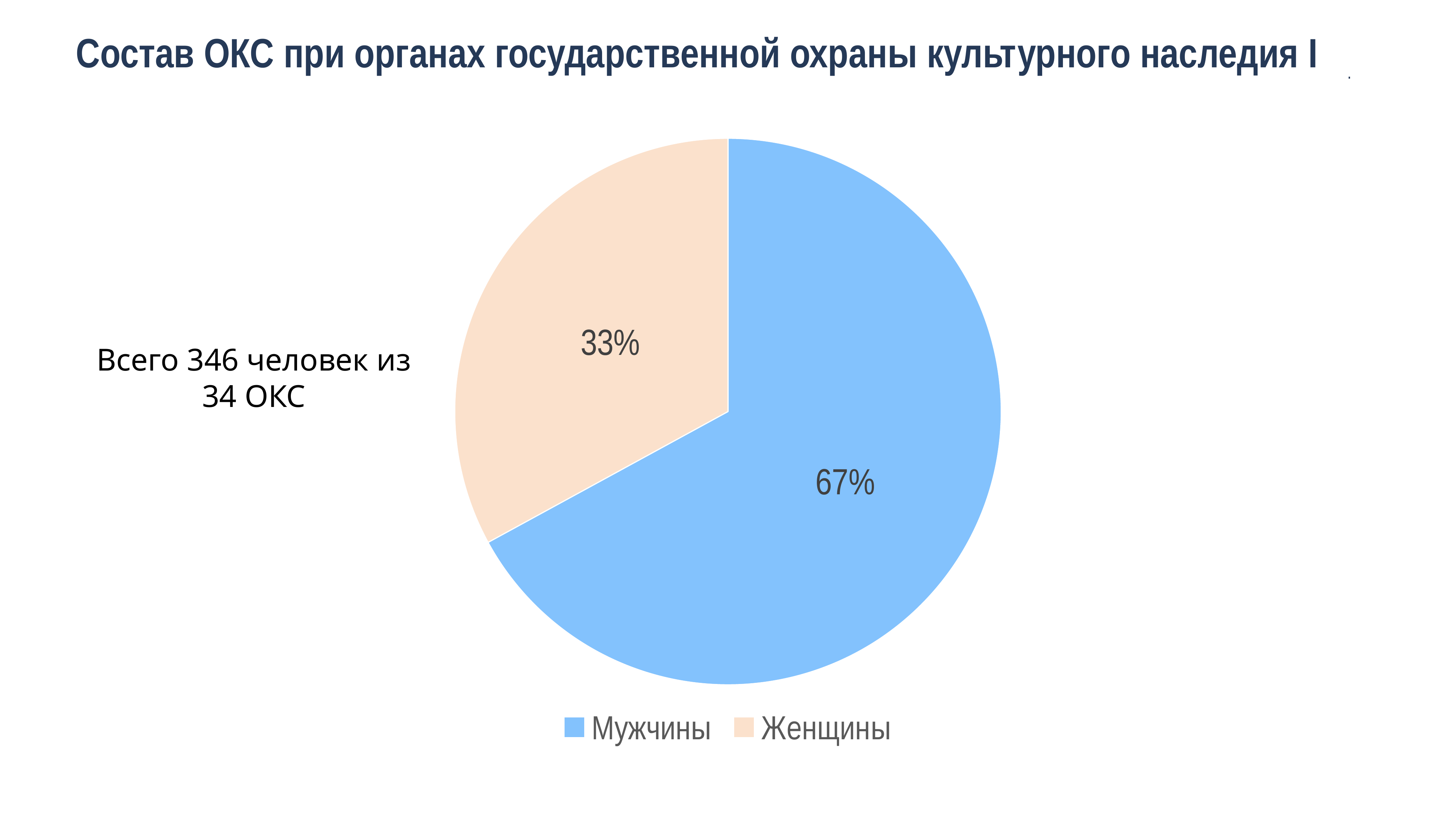
What kind of chart is shown on the slide? pie chart Which category has the largest slice of the pie? Мужчины What is the difference in percentage points between the Мужчины and Женщины slices? 34 What is the title of the slide? Состав ОКС при органах государственной охраны культурного наследия What share of the pie does Женщины represent? 33% How many slices does the pie chart have? 2 Which is larger, the slice for Мужчины or the slice for Женщины? Мужчины What colour is the Мужчины slice? blue What share of the pie does Мужчины represent? 67% Which category has the smallest slice of the pie? Женщины How many entries does the legend list? 2